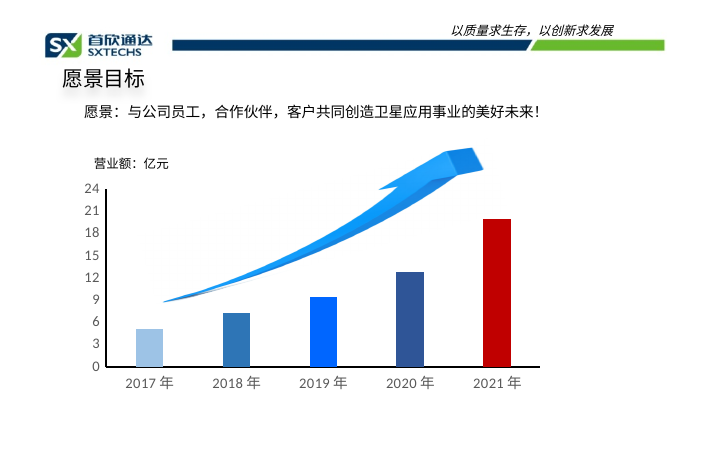
Is the value for 2021 年 greater or less than 18? greater How many years are plotted on the chart? 5 Which year has the highest bar on the chart? 2021 年 What unit is given for the values on the chart? 亿元 Is the value for 2020 年 greater or less than 9? greater Which is larger, the value for 2020 年 or the value for 2021 年? 2021 年 Is the value for 2017 年 greater or less than 6? less What kind of chart is shown on the slide? bar chart Do the values rise or fall from 2017 年 to 2021 年? rise Which year has the lowest bar on the chart? 2017 年 Which is larger, the value for 2017 年 or the value for 2018 年? 2018 年